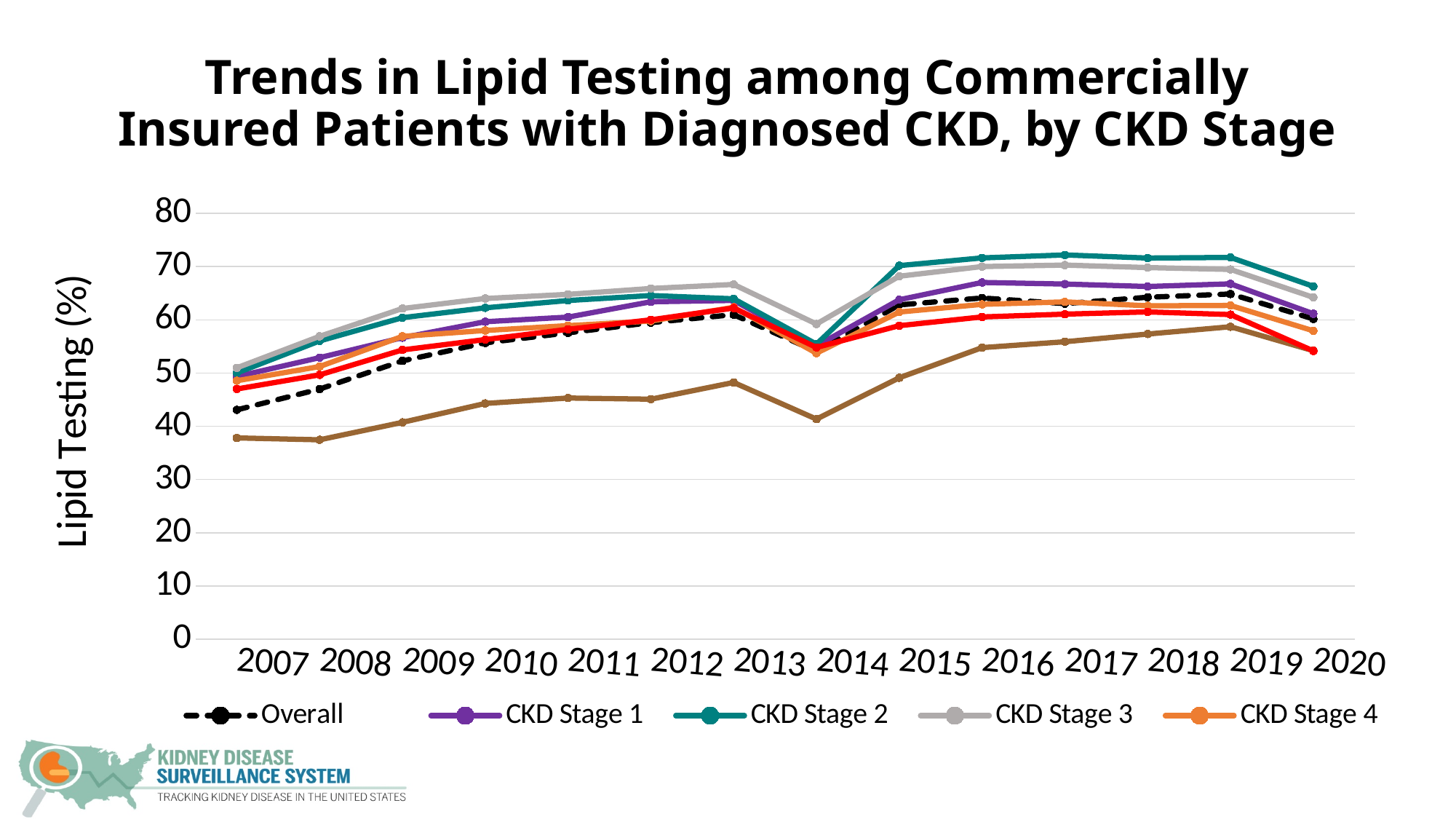
What is the label of the y axis? Lipid Testing (%) Is the Overall value larger in 2007 or in 2020? 2020 Is the Overall value in 2014 greater or less than 60? less Is the CKD Stage 4 value in 2014 greater or less than 60? less Which legend series has the lowest value in 2007? Overall How many years are shown along the x axis? 14 What kind of chart is shown on the slide? line chart Does the Overall line rise or fall from 2007 to 2013? rise Which legend series has the highest value in 2017? CKD Stage 2 Is the Overall value in 2007 greater or less than 50? less How many series does the legend list? 5